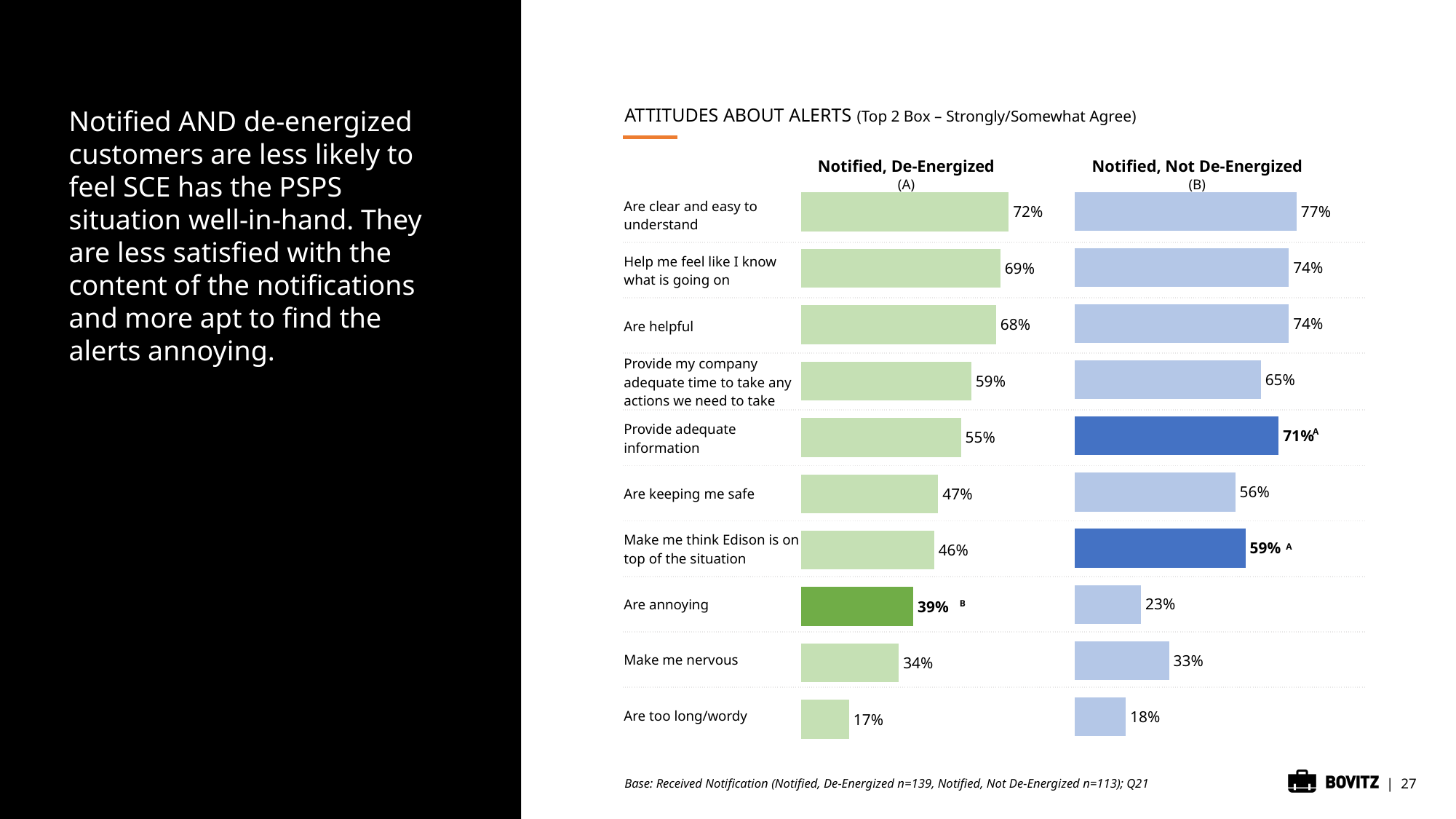
What type of chart is used to show attitudes about alerts? Bar chart What is the difference between the Notified, Not De-Energized and Notified, De-Energized percentages for 'Provide adequate information'? 16 percentage points How many customer groups (series) does the chart compare? 2 What percentage of Notified, De-Energized customers agree that alerts are annoying? 39% For 'Make me think Edison is on top of the situation', which group has the higher percentage? Notified, Not De-Energized Which attitude statement has the lowest agreement among Notified, De-Energized customers? Are too long/wordy What is the title of the chart? ATTITUDES ABOUT ALERTS (Top 2 Box – Strongly/Somewhat Agree) What percentage of Notified, De-Energized customers agree that alerts are clear and easy to understand? 72% What percentage of Notified, Not De-Energized customers agree that alerts provide adequate information? 71% For 'Are annoying', which group has the higher percentage: Notified, De-Energized or Notified, Not De-Energized? Notified, De-Energized Which attitude statement has the highest agreement among Notified, Not De-Energized customers? Are clear and easy to understand How many attitude statements are shown in the chart? 10